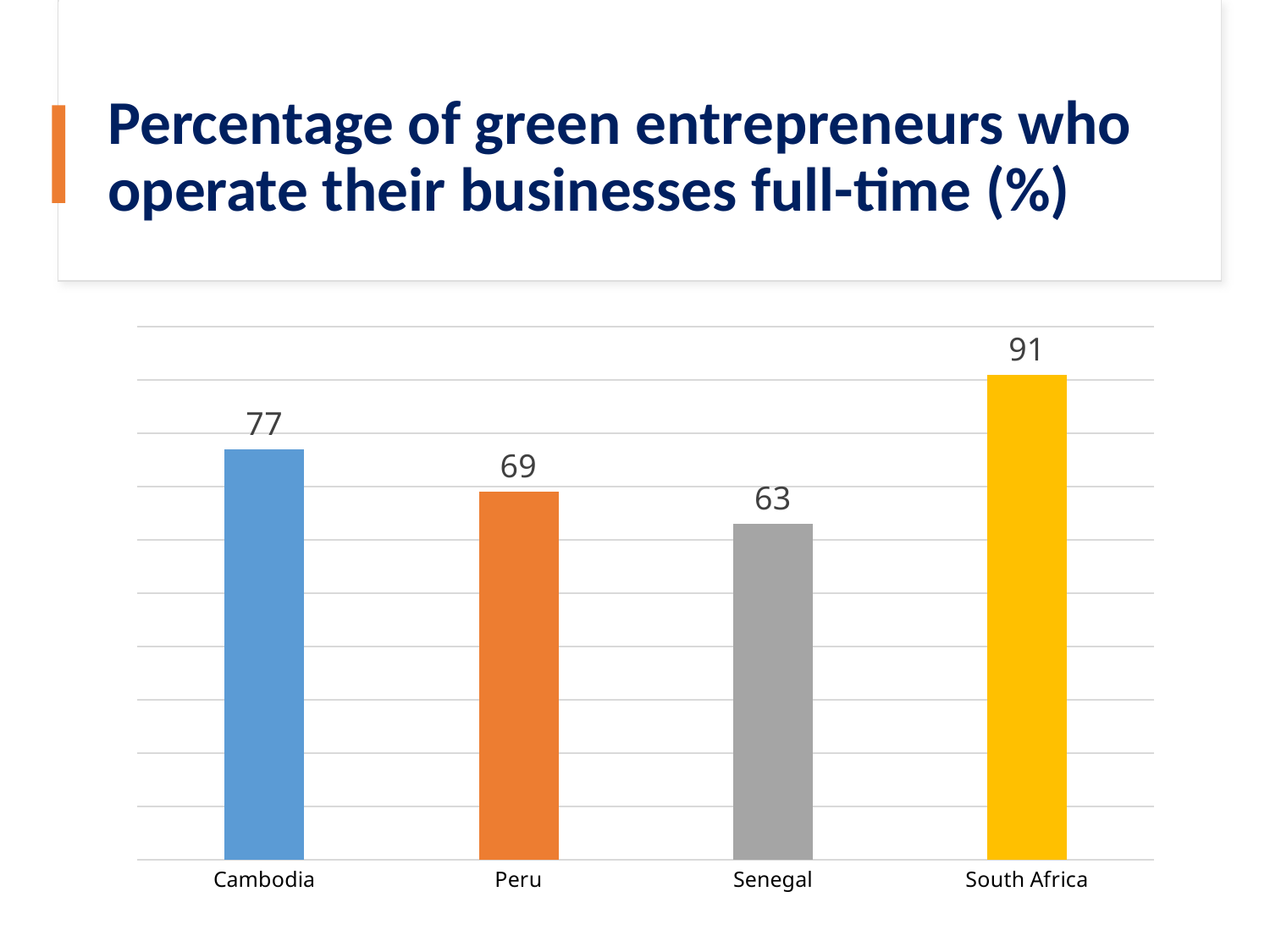
What is the value for Cambodia? 77 What kind of chart is shown on the slide? Bar chart Which is larger, the value for Cambodia or the value for Peru? Cambodia Which country has the lowest percentage of green entrepreneurs operating full-time? Senegal How many countries are shown in the chart? 4 Which country has the highest percentage of green entrepreneurs operating full-time? South Africa What colour is the bar for South Africa? Yellow What is the value for South Africa? 91 What is the value for Peru? 69 What is the difference between the values for Cambodia and Peru? 8 What is the difference between the values for South Africa and Senegal? 28 What is the value for Senegal? 63